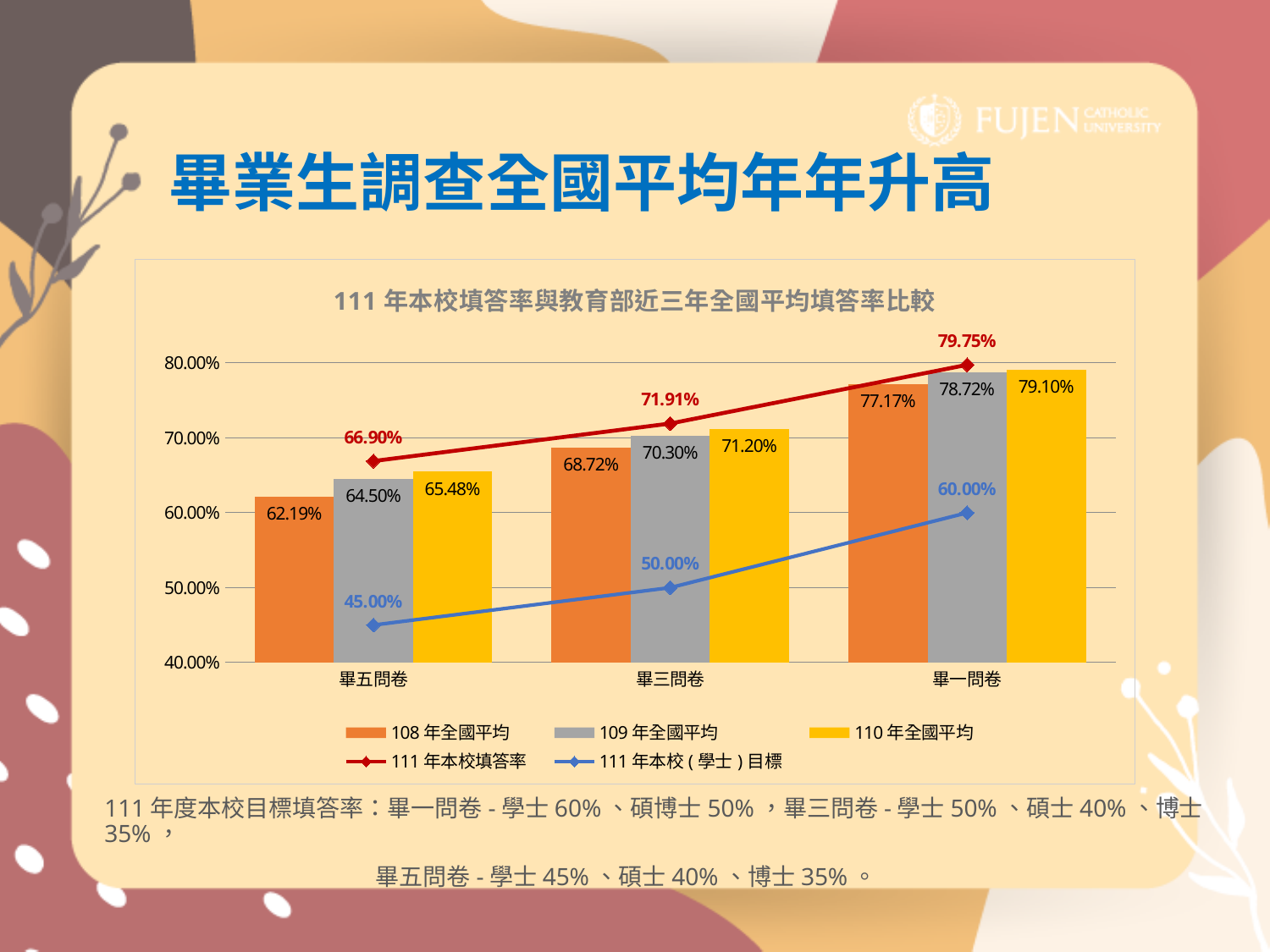
Which category has the lowest value for 111 年本校填答率? 畢五問卷 What is the title of the chart? 111 年本校填答率與教育部近三年全國平均填答率比較 What is the difference between 111 年本校填答率 and 110 年全國平均 for 畢一問卷? 0.65% What is the value of 110 年全國平均 for 畢三問卷? 71.20% Do the values of 111 年本校(學士)目標 rise or fall from 畢五問卷 to 畢一問卷? rise How many series does the legend list? 5 What is the value of 108 年全國平均 for 畢五問卷? 62.19% Which category has the highest value for 109 年全國平均? 畢一問卷 What is the value of 111 年本校填答率 for 畢一問卷? 79.75% How many categories are shown on the x axis? 3 What is the value of 111 年本校(學士)目標 for 畢三問卷? 50.00% Which is larger for 畢五問卷: 109 年全國平均 or 110 年全國平均? 110 年全國平均